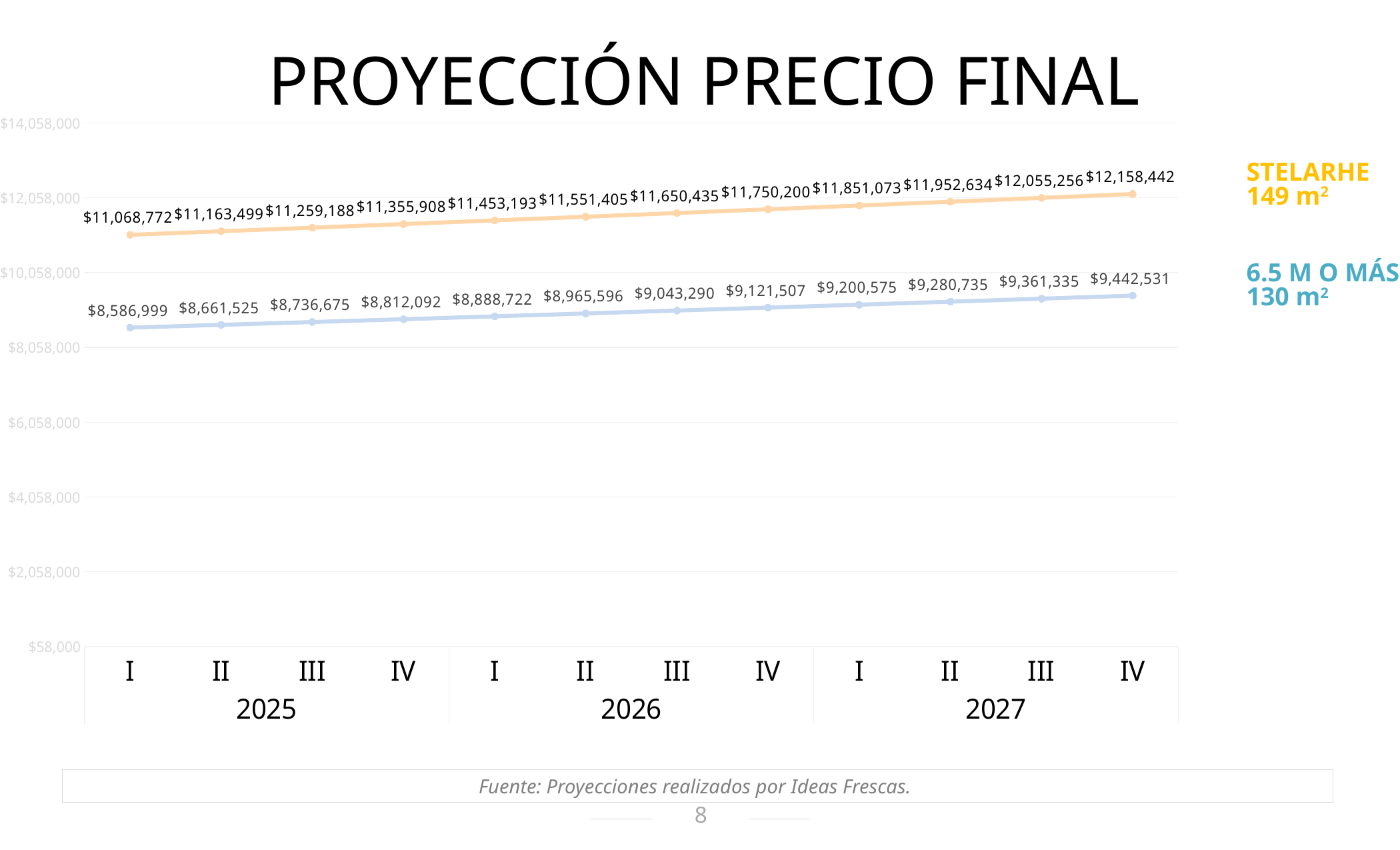
What is the projected price for 6.5 M O MÁS 130 m² in quarter II of 2026? $8,965,596 What is the projected price for STELARHE 149 m² in quarter III of 2026? $11,650,435 Which series has the higher value in quarter I of 2025, STELARHE 149 m² or 6.5 M O MÁS 130 m²? STELARHE 149 m² What kind of chart is shown on the slide? Line chart How many series are plotted on the chart? 2 What is the projected price for 6.5 M O MÁS 130 m² in quarter IV of 2027? $9,442,531 What is the projected price for STELARHE 149 m² in quarter I of 2025? $11,068,772 In which quarter does the STELARHE 149 m² series reach its highest value? IV 2027 In which quarter is the 6.5 M O MÁS 130 m² series at its lowest value? I 2025 How many data points does each series have on the chart? 12 What is the difference between the STELARHE 149 m² and 6.5 M O MÁS 130 m² values in quarter IV of 2027? $2,715,911 Do the values of the 6.5 M O MÁS 130 m² series rise or fall from 2025 to 2027? Rise